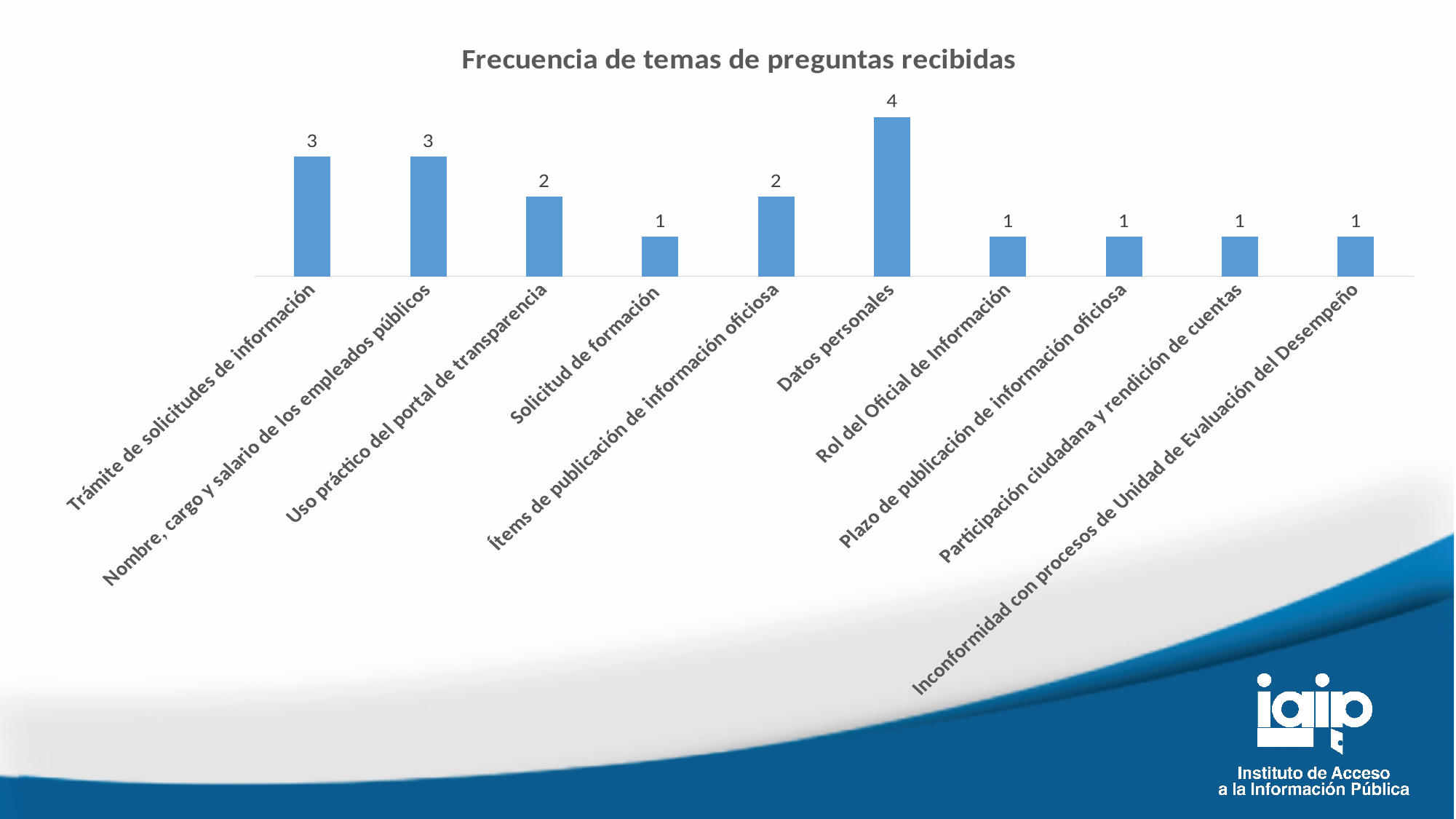
What kind of chart is shown on the slide? Bar chart What is the value for "Solicitud de formación"? 1 How many categories are shown on the chart? 10 What is the value for "Uso práctico del portal de transparencia"? 2 What is the value for "Datos personales"? 4 What is the difference between the values for "Datos personales" and "Nombre, cargo y salario de los empleados públicos"? 1 Which is larger: the value for "Ítems de publicación de información oficiosa" or the value for "Rol del Oficial de Información"? Ítems de publicación de información oficiosa Which category has the highest value? Datos personales How many categories have a value of 1? 5 What is the value for "Trámite de solicitudes de información"? 3 What is the title of the chart? Frecuencia de temas de preguntas recibidas What is the difference between the values for "Trámite de solicitudes de información" and "Solicitud de formación"? 2